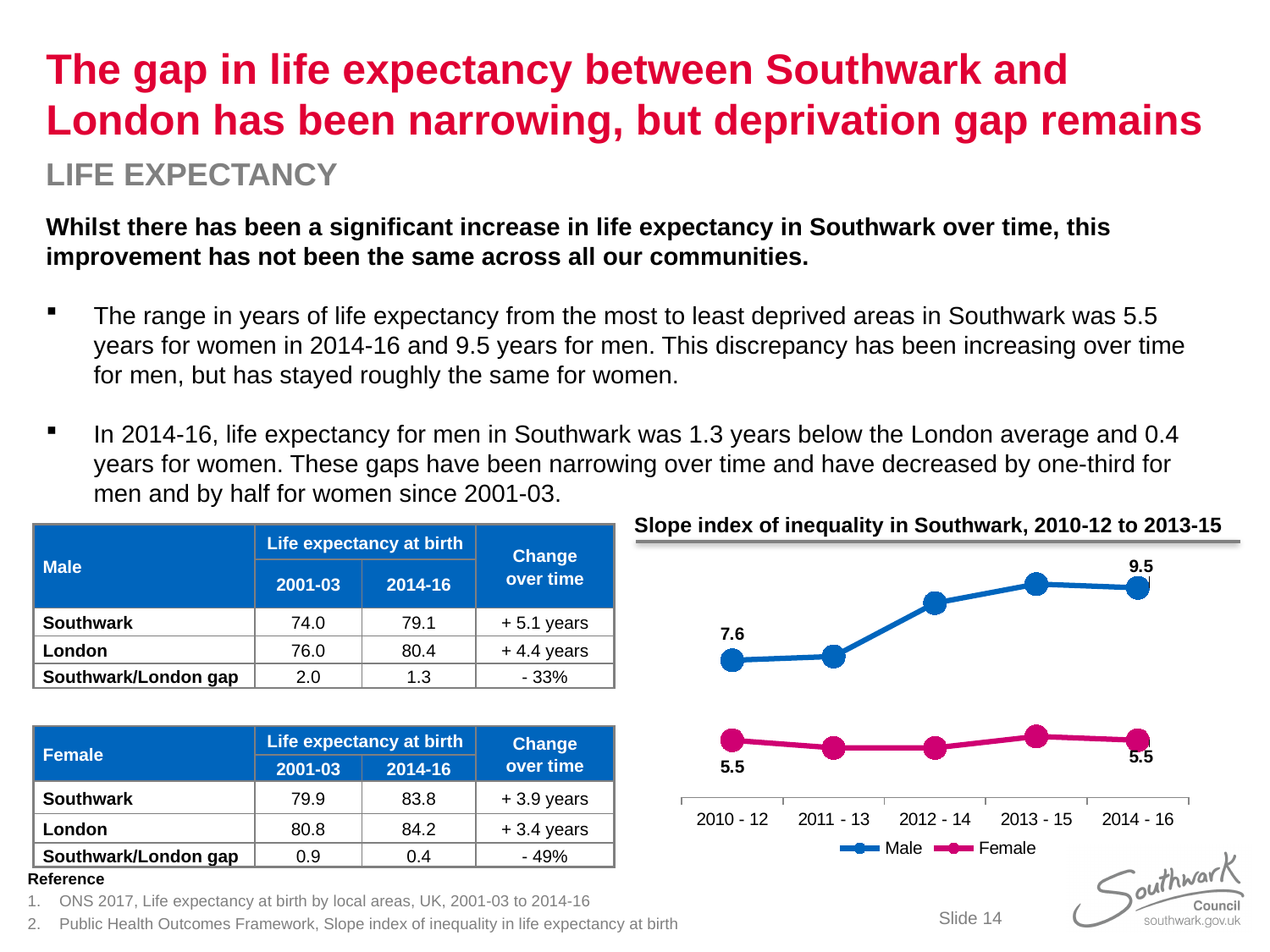
What is the Female slope index of inequality value for 2010 - 12? 5.5 Does the Male line generally rise or fall from 2010 - 12 to 2014 - 16? rise By how much did the Male value increase from 2010 - 12 to 2014 - 16? 1.9 In 2014 - 16, which series has the higher value, Male or Female? Male What are the two entries in the chart's legend? Male, Female What is the Male slope index of inequality value for 2010 - 12? 7.6 How many time periods are plotted along the x axis of the chart? 5 What is the Female slope index of inequality value for 2014 - 16? 5.5 What is the title of the chart? Slope index of inequality in Southwark, 2010-12 to 2013-15 How many series does the legend of the chart list? 2 What is the Male slope index of inequality value for 2014 - 16? 9.5 What kind of chart is shown on the slide? line chart